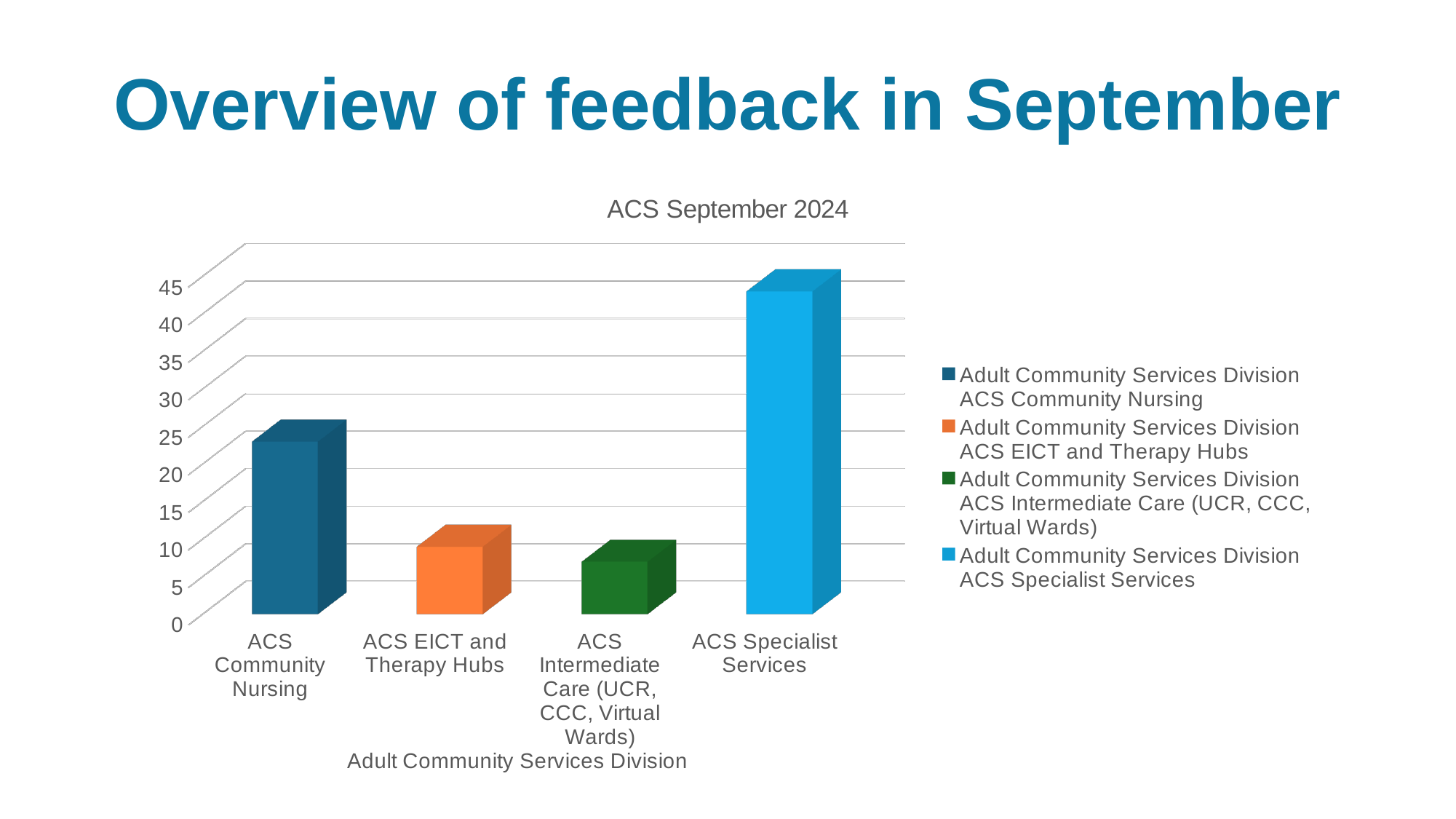
Is the value for ACS EICT and Therapy Hubs greater or less than 15? less Which is larger, the value for ACS Community Nursing or the value for ACS EICT and Therapy Hubs? ACS Community Nursing Is the value for ACS Community Nursing greater or less than 20? greater How many categories are shown on the x axis of the chart? 4 What colour is the bar for ACS Specialist Services? light blue What kind of chart is shown on the slide? bar chart Is the value for ACS Specialist Services greater or less than 40? greater What is the title of the chart? ACS September 2024 Which category has the lowest bar? ACS Intermediate Care (UCR, CCC, Virtual Wards) Which category has the highest bar? ACS Specialist Services How many entries does the chart's legend list? 4